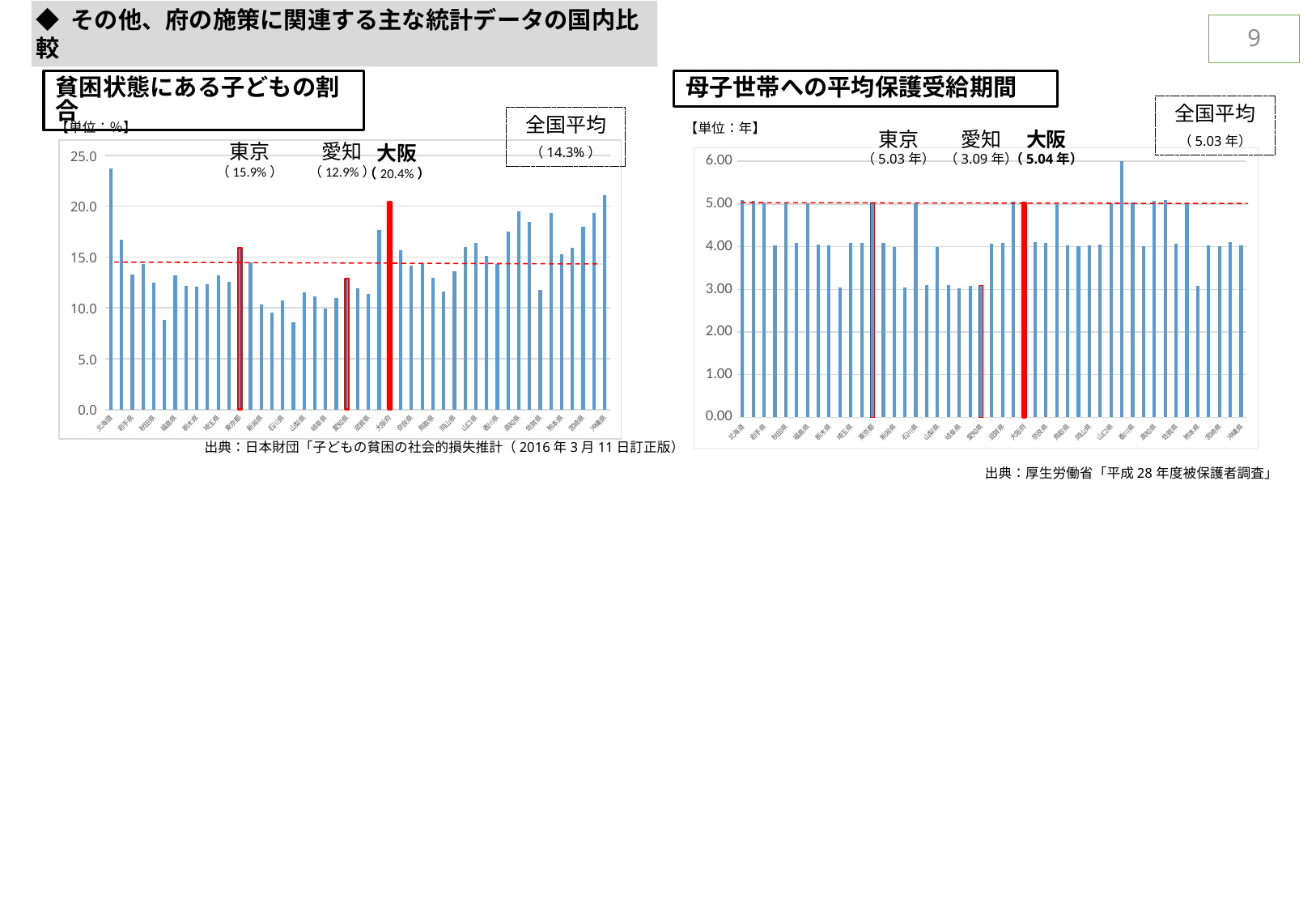
In the left chart (貧困状態にある子どもの割合), is the value for 大阪 greater or less than 20.0? greater In the left chart (貧困状態にある子どもの割合), what is the 全国平均 (national average) shown? 14.3% In the left chart (貧困状態にある子どもの割合), which is larger, 東京 or 愛知? 東京 In the left chart (貧困状態にある子どもの割合), how much higher is 大阪 than 東京? 4.5 percentage points In the right chart (母子世帯への平均保護受給期間), which is larger, 大阪 or 愛知? 大阪 In the left chart (貧困状態にある子どもの割合), what is the value for 東京? 15.9% In the right chart (母子世帯への平均保護受給期間), what is the difference between 大阪 and 愛知? 1.95年 In the right chart (母子世帯への平均保護受給期間), what is the 全国平均 (national average) shown? 5.03年 In the right chart (母子世帯への平均保護受給期間), what is the value for 愛知? 3.09年 What kind of chart is the left chart (貧困状態にある子どもの割合)? bar chart In the right chart (母子世帯への平均保護受給期間), what is the value for 大阪? 5.04年 In the left chart (貧困状態にある子どもの割合), what is the value for 大阪? 20.4%